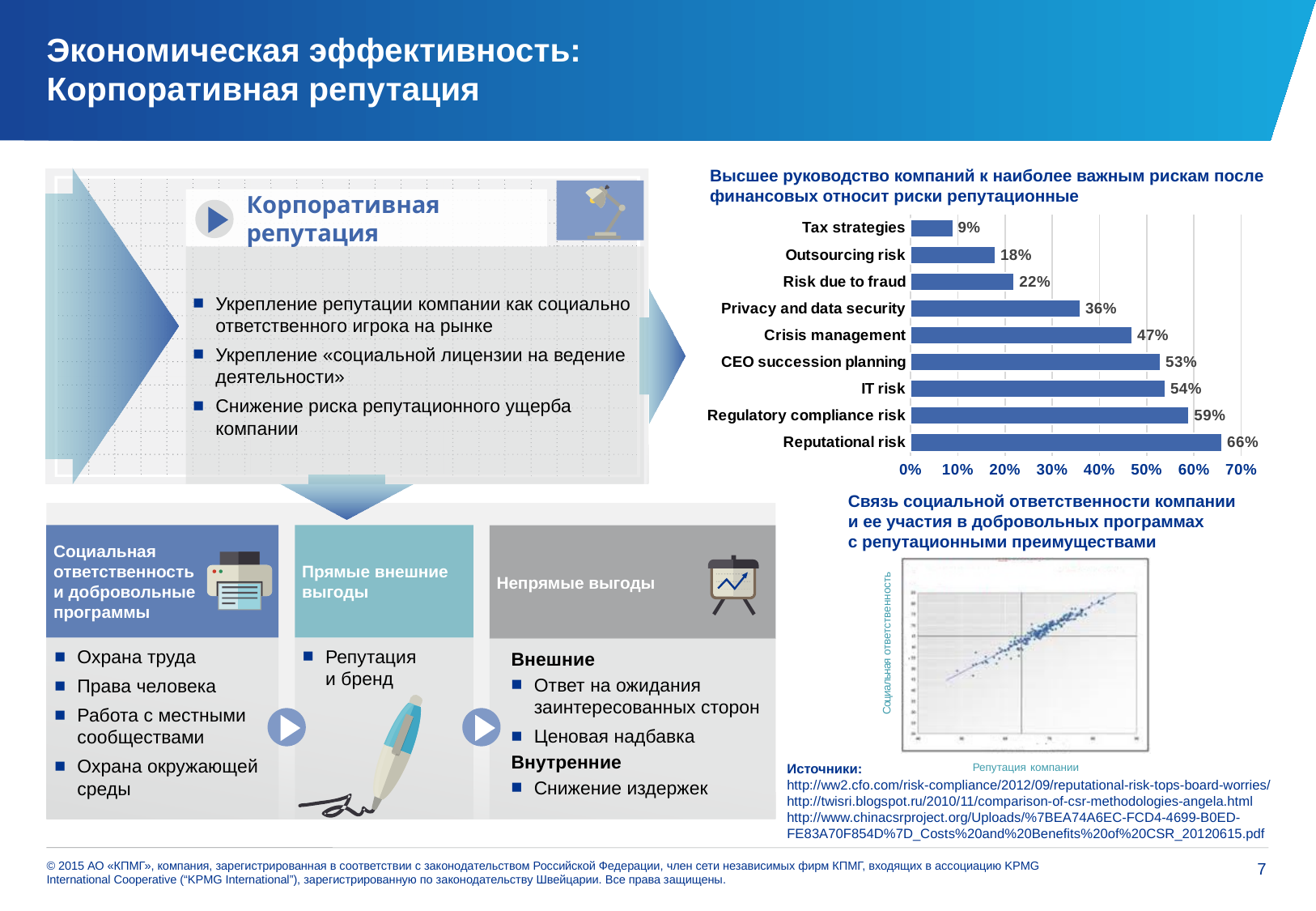
In the bar chart in the upper right of the slide, what is the value for Reputational risk? 66% In the bar chart in the upper right of the slide, which is larger: Risk due to fraud or Privacy and data security? Privacy and data security In the bar chart in the upper right of the slide, is the value for CEO succession planning greater or less than 50%? greater In the bar chart in the upper right of the slide, what is the difference between Reputational risk and IT risk? 12% How many categories are shown in the bar chart in the upper right of the slide? 9 What kind of chart is the small chart in the lower right of the slide, below the bar chart? Scatter plot In the bar chart in the upper right of the slide, which category has the highest value? Reputational risk In the bar chart in the upper right of the slide, which category has the lowest value? Tax strategies In the bar chart in the upper right of the slide, what is the value for Privacy and data security? 36% In the bar chart in the upper right of the slide, what is the difference between Regulatory compliance risk and Outsourcing risk? 41% In the bar chart in the upper right of the slide, what is the value for Crisis management? 47% What kind of chart is the chart in the upper right of the slide showing risk categories? Bar chart